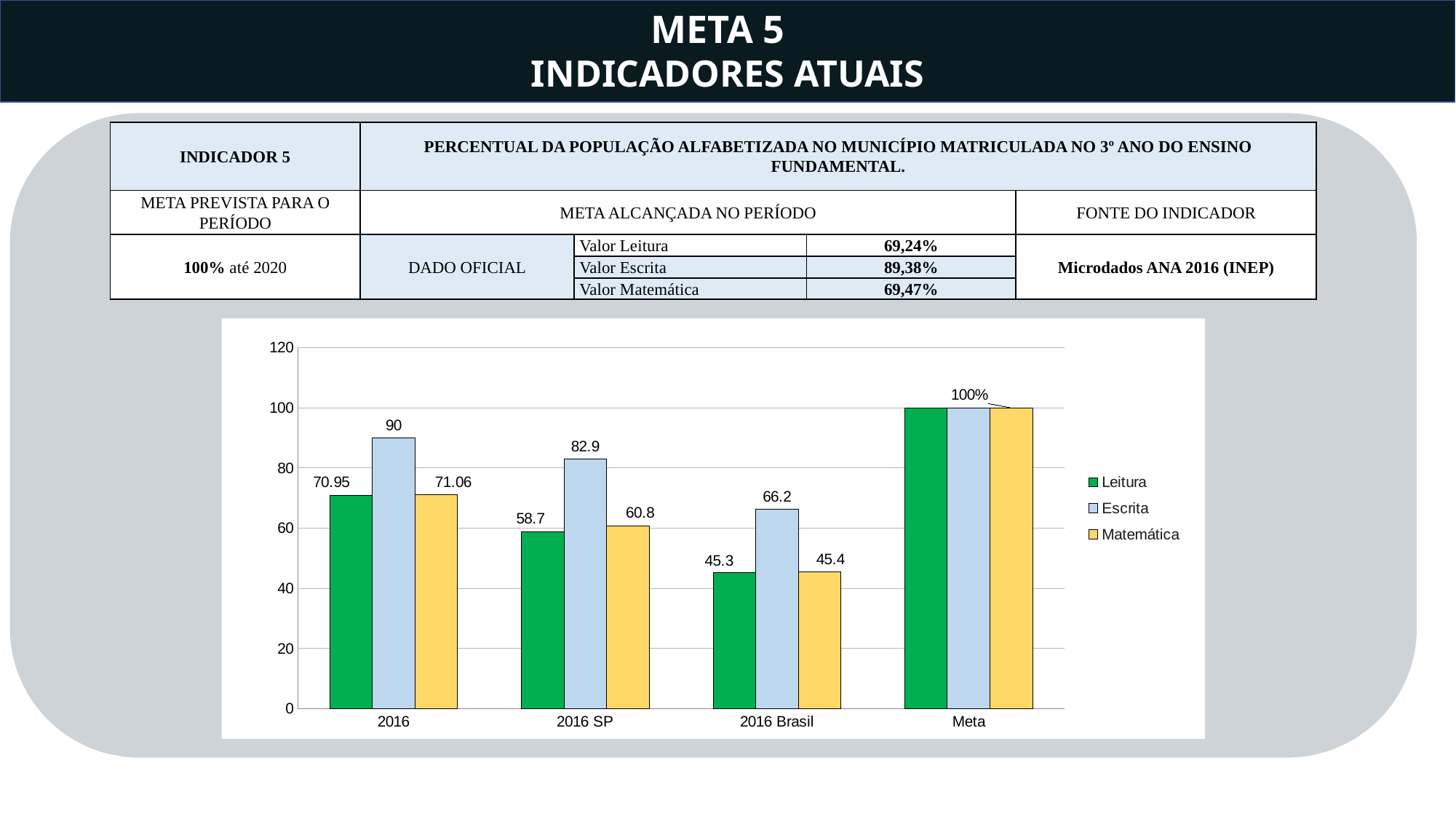
What is the Matemática value for 2016 Brasil? 45.4 What value is labelled for the Meta category? 100% Which series has the highest value in the 2016 SP category? Escrita How many series does the chart legend list? 3 Do the Leitura values rise or fall from 2016 to 2016 Brasil? fall Is the Escrita value for 2016 SP larger than the Matemática value for 2016 SP? Yes What type of chart is shown on the slide? bar chart Which category has the lowest Leitura value? 2016 Brasil What is the Leitura value for 2016 SP? 58.7 How many categories are shown on the x axis of the chart? 4 What is the Escrita value for the 2016 category? 90 What is the difference between the Escrita values for 2016 and 2016 Brasil? 23.8